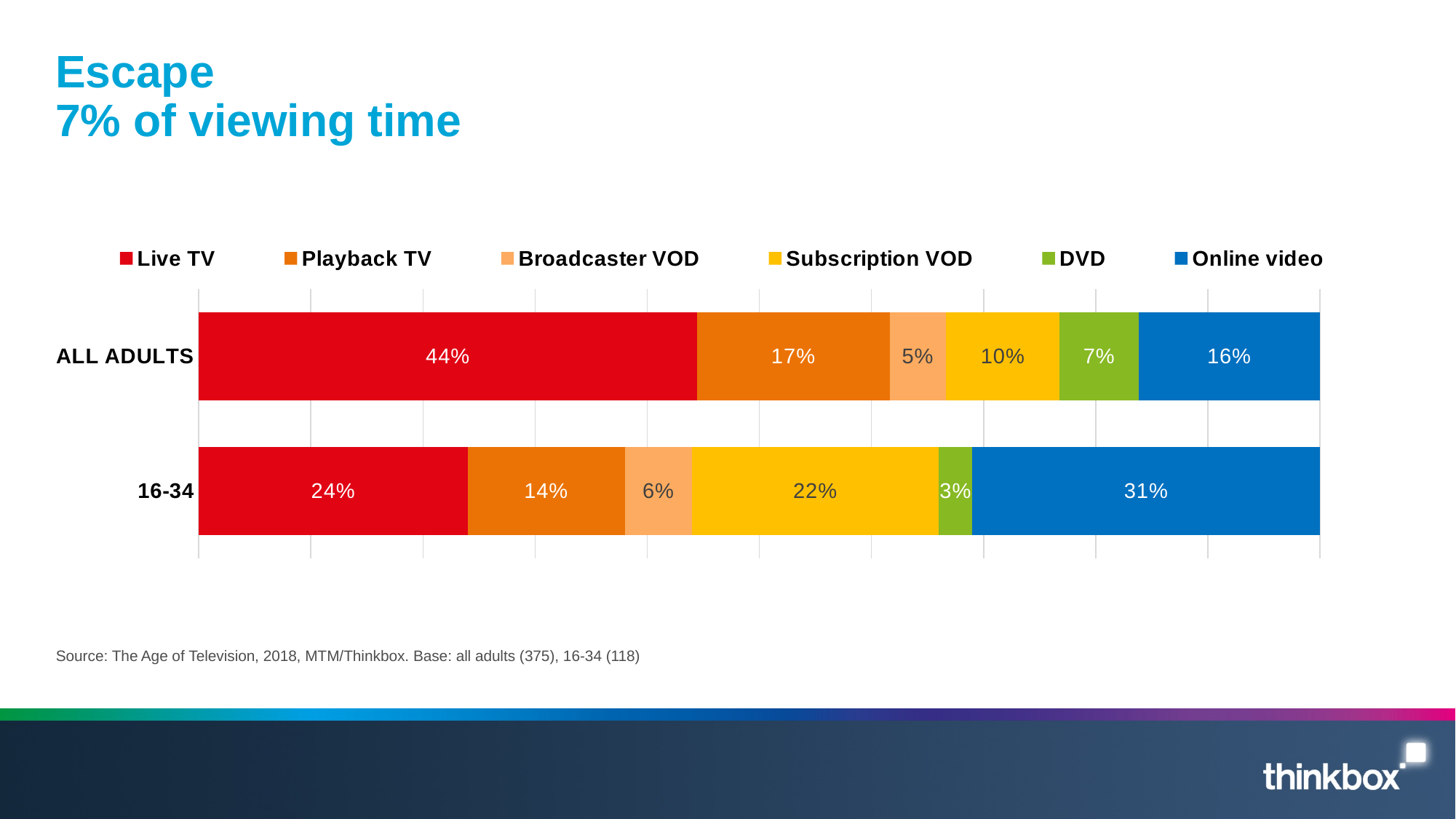
Which series has the largest share for ALL ADULTS? Live TV How many series does the legend list? 6 What is the Live TV value for ALL ADULTS? 44% What is the difference between the Live TV values for ALL ADULTS and 16-34? 20% What is the DVD value for ALL ADULTS? 7% What is the Online video value for the 16-34 group? 31% What is the Subscription VOD value for the 16-34 group? 22% What is the total of the stacked bar for the 16-34 group? 100% Which is larger for the 16-34 group: Online video or Live TV? Online video What kind of chart is shown on the slide? Stacked bar chart How many categories (bars) are shown on the chart? 2 Which series has the smallest share for the 16-34 group? DVD